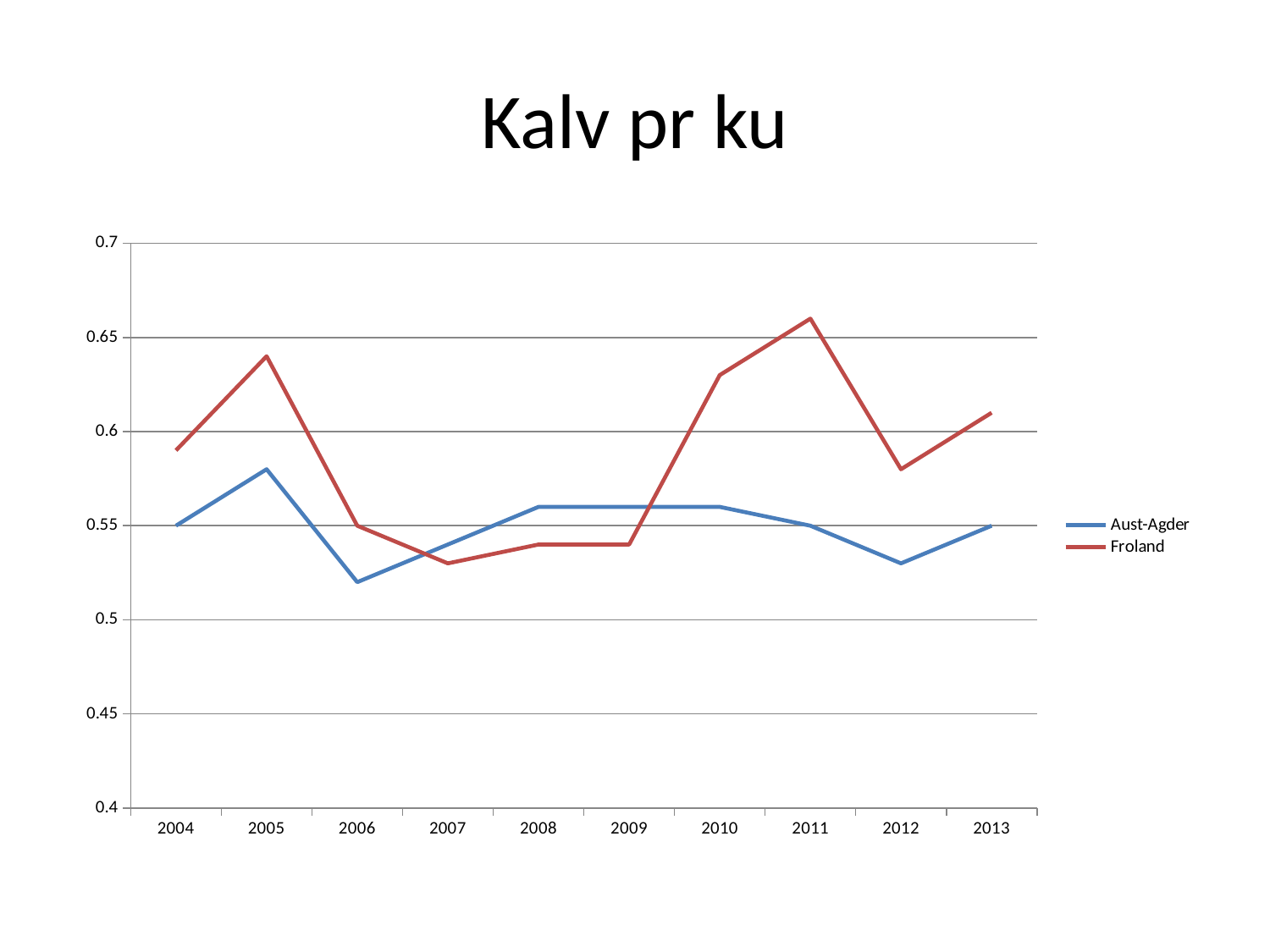
Is the value for Aust-Agder in 2006 greater or less than 0.5? greater Does the Froland line rise or fall from 2011 to 2012? fall What is the value for Froland in 2006? 0.55 What is the value for Aust-Agder in 2004? 0.55 How many years are shown on the x axis? 10 In which year does Aust-Agder reach its lowest value? 2006 What is the title of the chart? Kalv pr ku In which year does Froland reach its highest value? 2011 Is the value for Froland in 2011 greater or less than 0.65? greater Which series has the larger value in 2005, Aust-Agder or Froland? Froland How many series does the legend list? 2 What kind of chart is shown on the slide? line chart